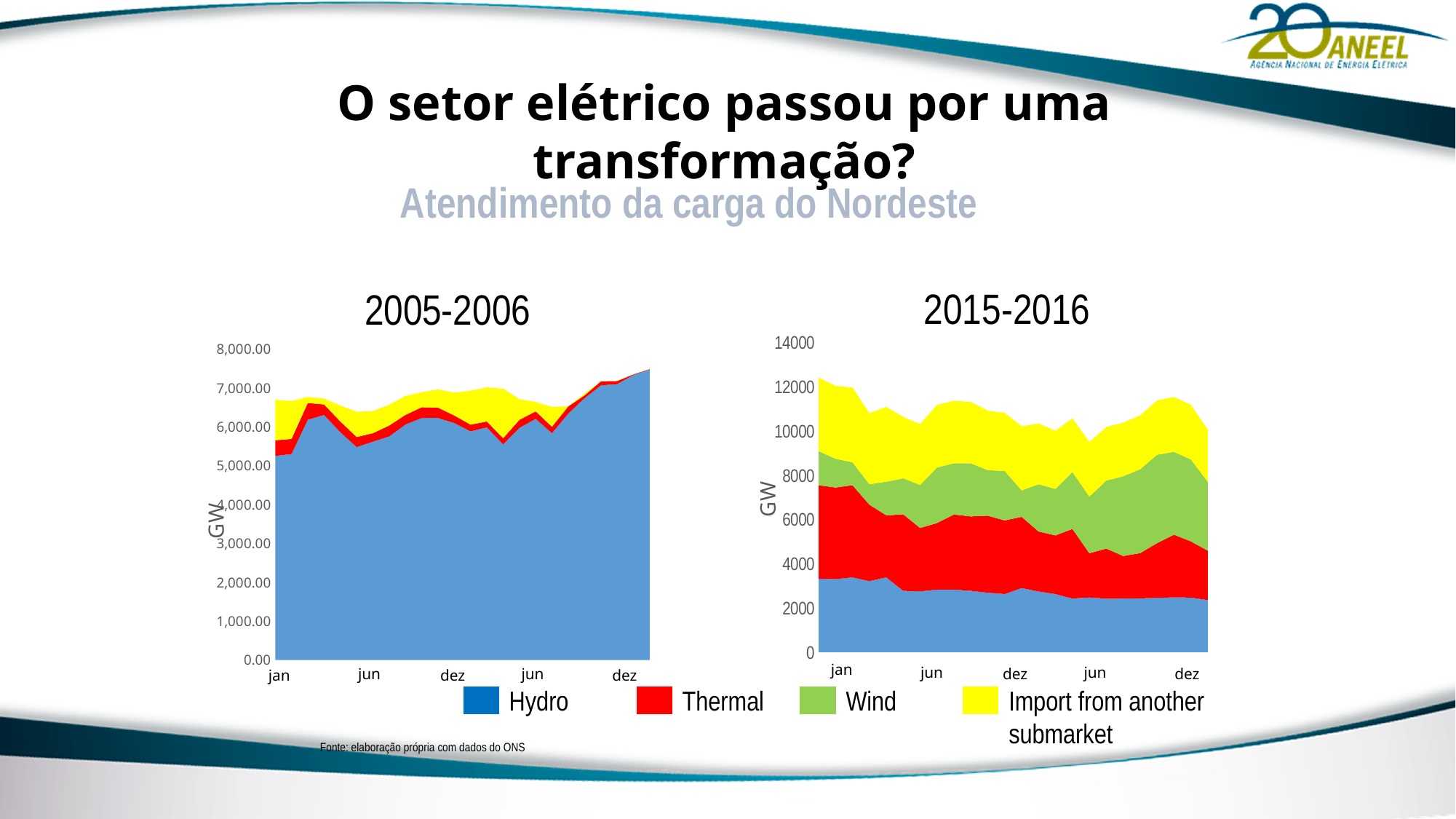
In the 2015-2016 chart, is the Hydro value larger at the first jan or at the final dez? first jan In the 2015-2016 chart, is the total stacked value at the final dez greater or less than 12000? less How many series does the legend list? 4 What label is shown on the vertical axis of the 2015-2016 chart? GW In the 2015-2016 chart, does the Hydro series rise or fall from the first jan to the final dez? fall In the 2005-2006 chart, is the Hydro value at the final dez greater or less than 7,000.00? greater In the 2005-2006 chart, is the total stacked value at the first jan greater or less than 7,000.00? less In the 2005-2006 chart, does the Hydro series rise or fall from the first jan to the final dez? rise Which series is shown in yellow in the legend? Import from another submarket What kind of chart is the 2005-2006 chart? stacked area chart